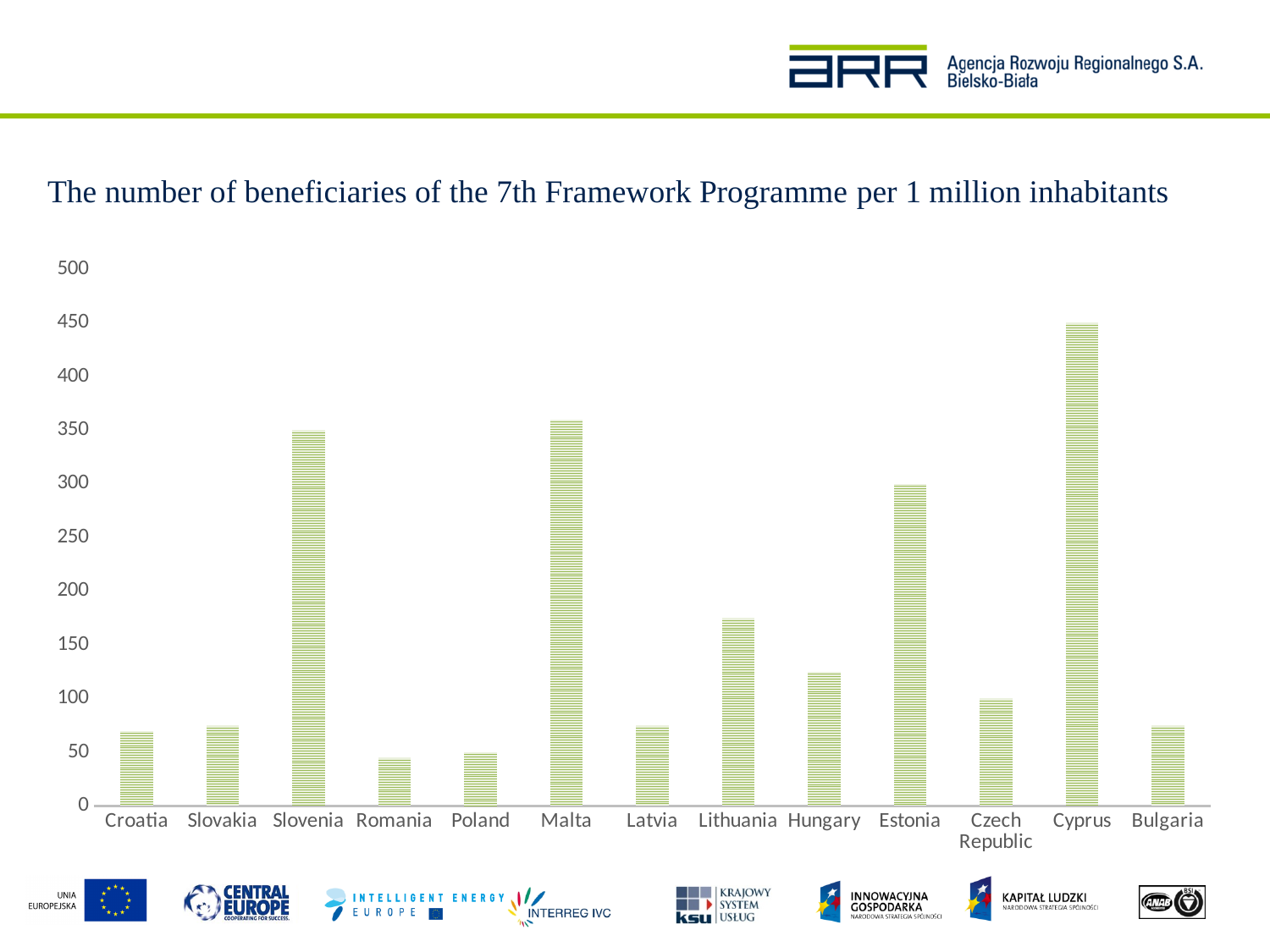
Is the value for Romania greater or less than 50? less What is the title of the chart? The number of beneficiaries of the 7th Framework Programme per 1 million inhabitants Is the value for Slovenia greater or less than 300? greater What type of chart is shown on the slide? bar chart How many countries are shown on the x axis of the chart? 13 Is the value for Lithuania greater or less than 150? greater Which is larger, the value for Lithuania or the value for Hungary? Lithuania Which is larger, the value for Cyprus or the value for Malta? Cyprus Which country has the highest number of beneficiaries per 1 million inhabitants? Cyprus